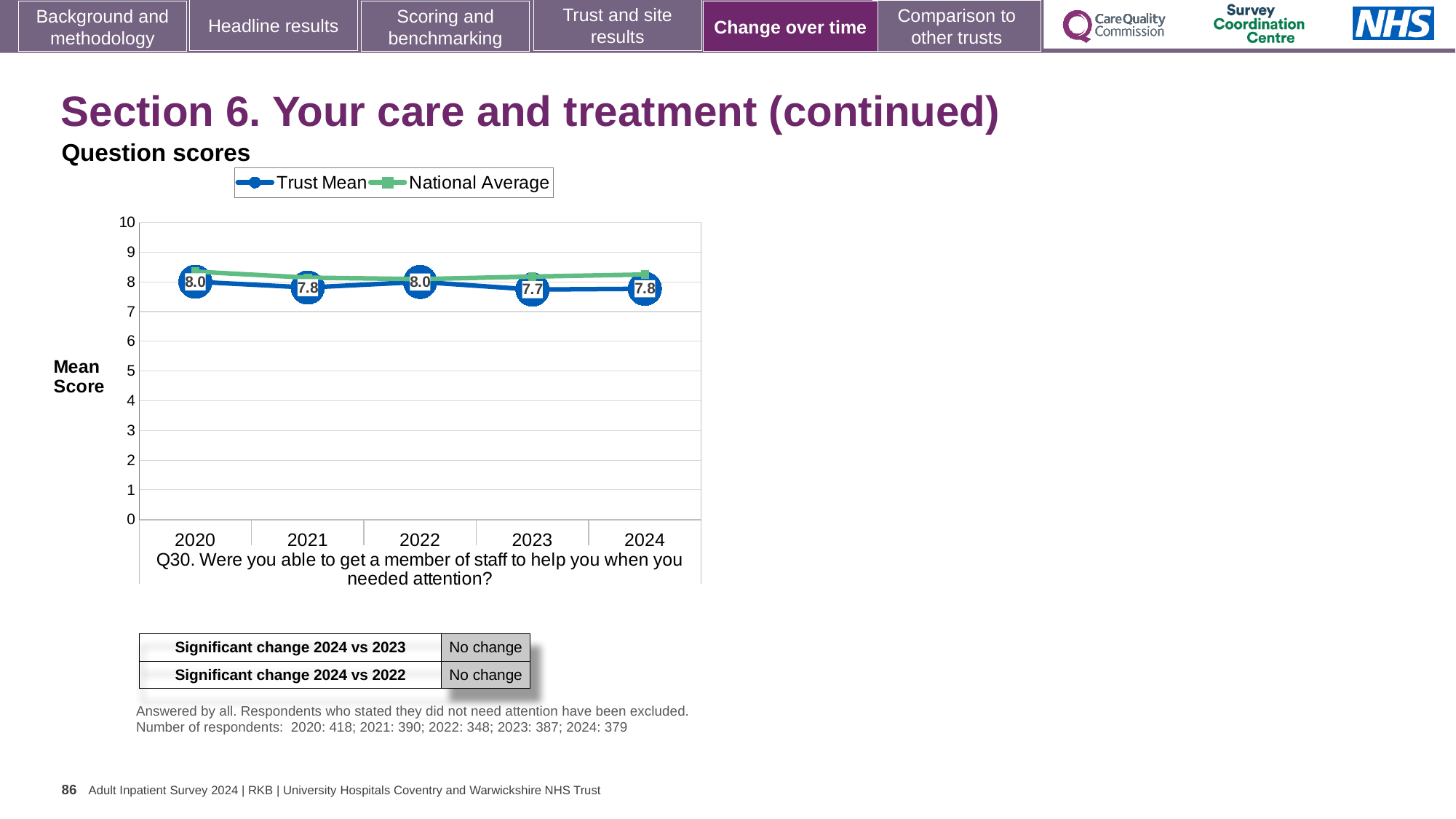
What kind of chart is shown? Line chart What is the Trust Mean score for 2024? 7.8 How many years are plotted on the x axis? 5 Does the Trust Mean score rise or fall from 2022 to 2023? Fall What is the Trust Mean score for 2020? 8.0 How many series does the legend list? 2 What is the label on the y axis of the chart? Mean Score What is the Trust Mean score for 2023? 7.7 Is the National Average value for 2024 greater or less than 7? greater What is the difference between the Trust Mean score in 2020 and in 2023? 0.3 In which year is the Trust Mean score lowest? 2023 Which is larger, the Trust Mean score in 2022 or in 2024? 2022